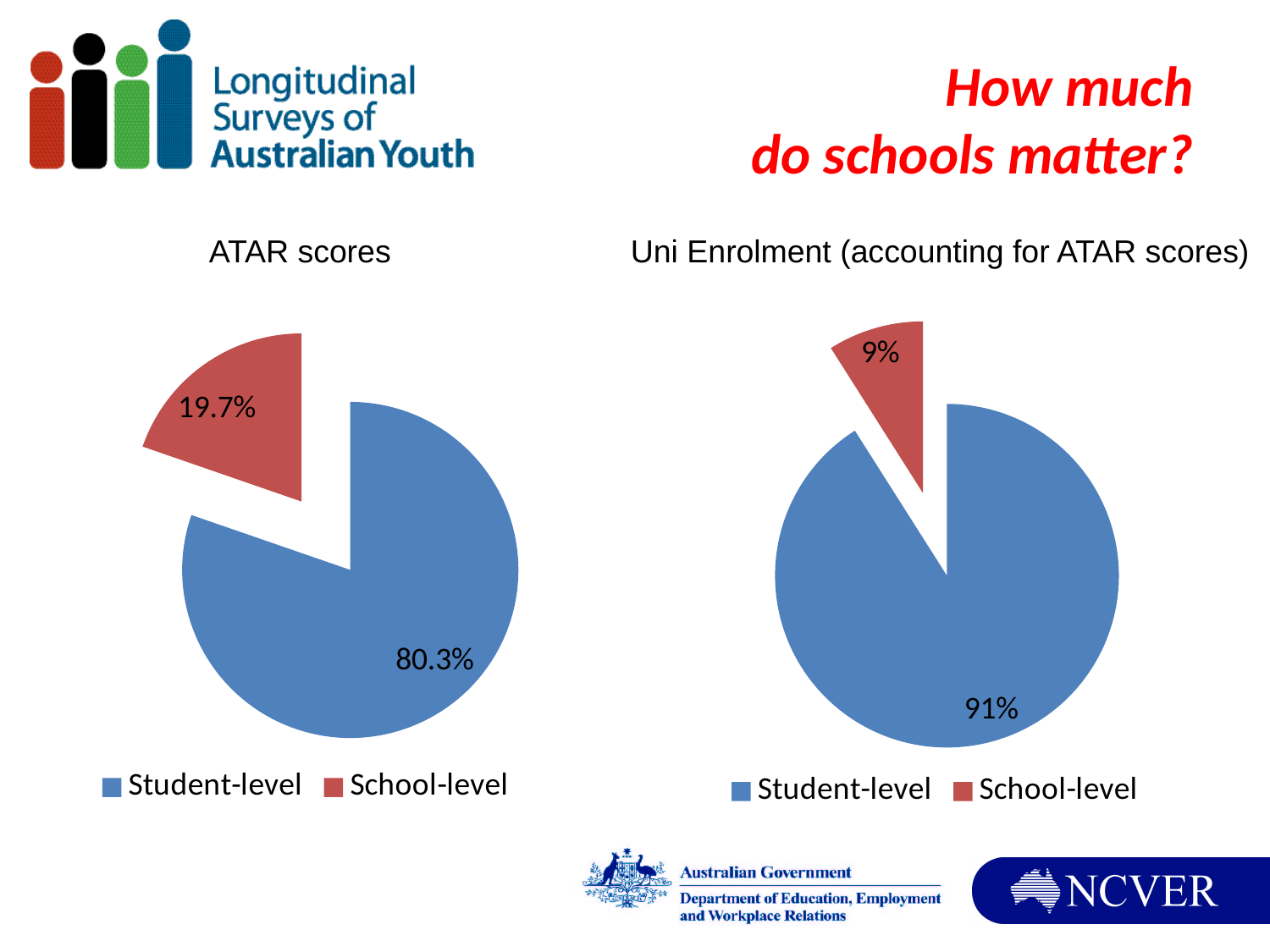
In the Uni Enrolment (accounting for ATAR scores) chart, what share is labelled for School-level? 9% In the ATAR scores chart, what share is labelled for Student-level? 80.3% How many slices does the Uni Enrolment (accounting for ATAR scores) chart have? 2 In the Uni Enrolment (accounting for ATAR scores) chart, what is the difference between the Student-level and School-level shares? 82% In the ATAR scores chart, what colour is the School-level slice? Red In the ATAR scores chart, which slice is the largest? Student-level Is the School-level share larger in the ATAR scores chart or in the Uni Enrolment (accounting for ATAR scores) chart? ATAR scores In the ATAR scores chart, what share is labelled for School-level? 19.7% In the ATAR scores chart, what is the difference between the Student-level and School-level shares? 60.6% In the Uni Enrolment (accounting for ATAR scores) chart, which slice is the smallest? School-level In the Uni Enrolment (accounting for ATAR scores) chart, what share is labelled for Student-level? 91% What kind of chart is the ATAR scores chart? Pie chart